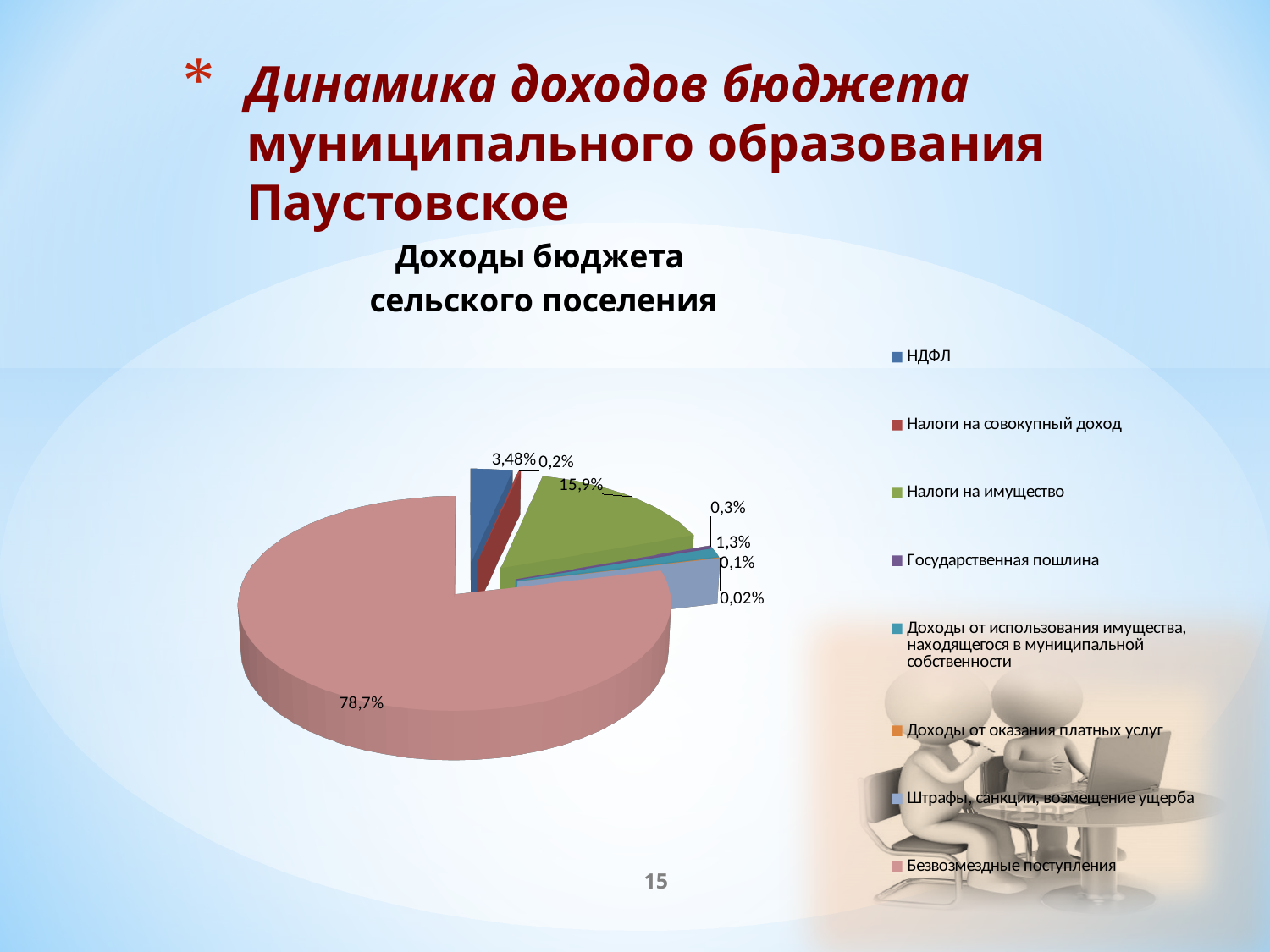
What is the difference between the shares of Безвозмездные поступления and Налоги на имущество? 62,8% Which is larger: the share of НДФЛ or the share of Налоги на имущество? Налоги на имущество What is the title of the chart? Доходы бюджета сельского поселения What kind of chart is shown on the slide? pie chart What is the value shown for Налоги на совокупный доход? 0,2% What colour is the slice for Безвозмездные поступления? pink Which category has the largest slice of the pie? Безвозмездные поступления What is the value shown for Налоги на имущество? 15,9% What is the value shown for НДФЛ? 3,48% What is the smallest value labelled on the pie chart? 0,02% How many categories does the legend of the pie chart list? 8 What share of the pie does Безвозмездные поступления have? 78,7%